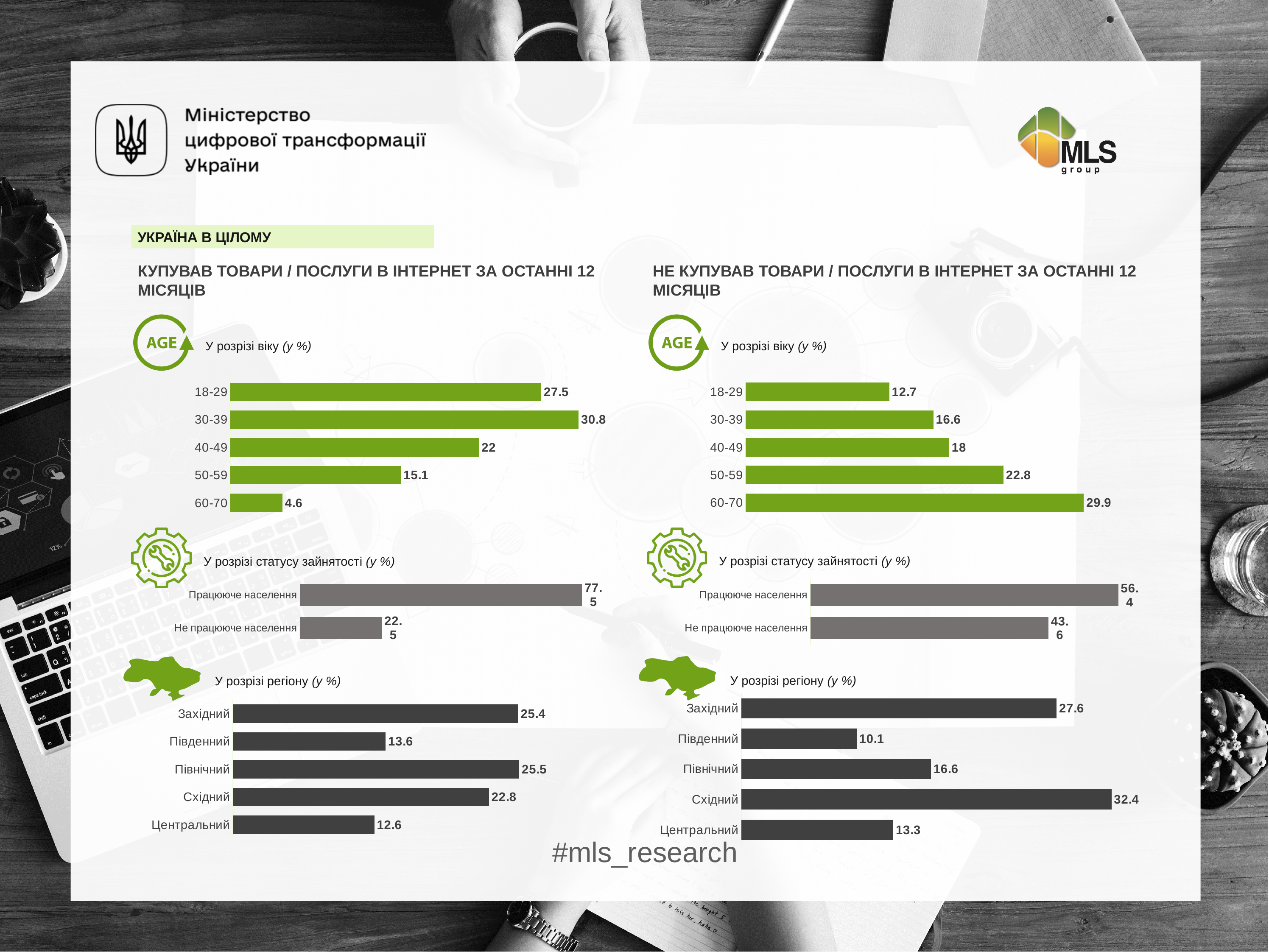
In the right region chart (did not buy online), which region has the lowest value? Південний In the right region chart (did not buy online), which region has the highest value? Східний In the left employment status chart (bought online), what is the value for Працююче населення? 77.5 In the right employment status chart (did not buy online), what is the value for Не працююче населення? 43.6 In the right age chart (did not buy online), do the values rise or fall as the age groups get older? rise In the left age chart (bought goods/services online in the last 12 months), what is the value for the 30-39 age group? 30.8 How many age groups are shown in the left age chart (bought online)? 5 In the right age chart (did not buy online), what is the value for the 50-59 age group? 22.8 In the left region chart (bought online), what is the value for Східний? 22.8 In the left age chart (bought online), which age group has the lowest value? 60-70 In the right age chart (did not buy online), which age group has the highest value? 60-70 In the left age chart (bought online), what is the difference between the 18-29 and 60-70 values? 22.9